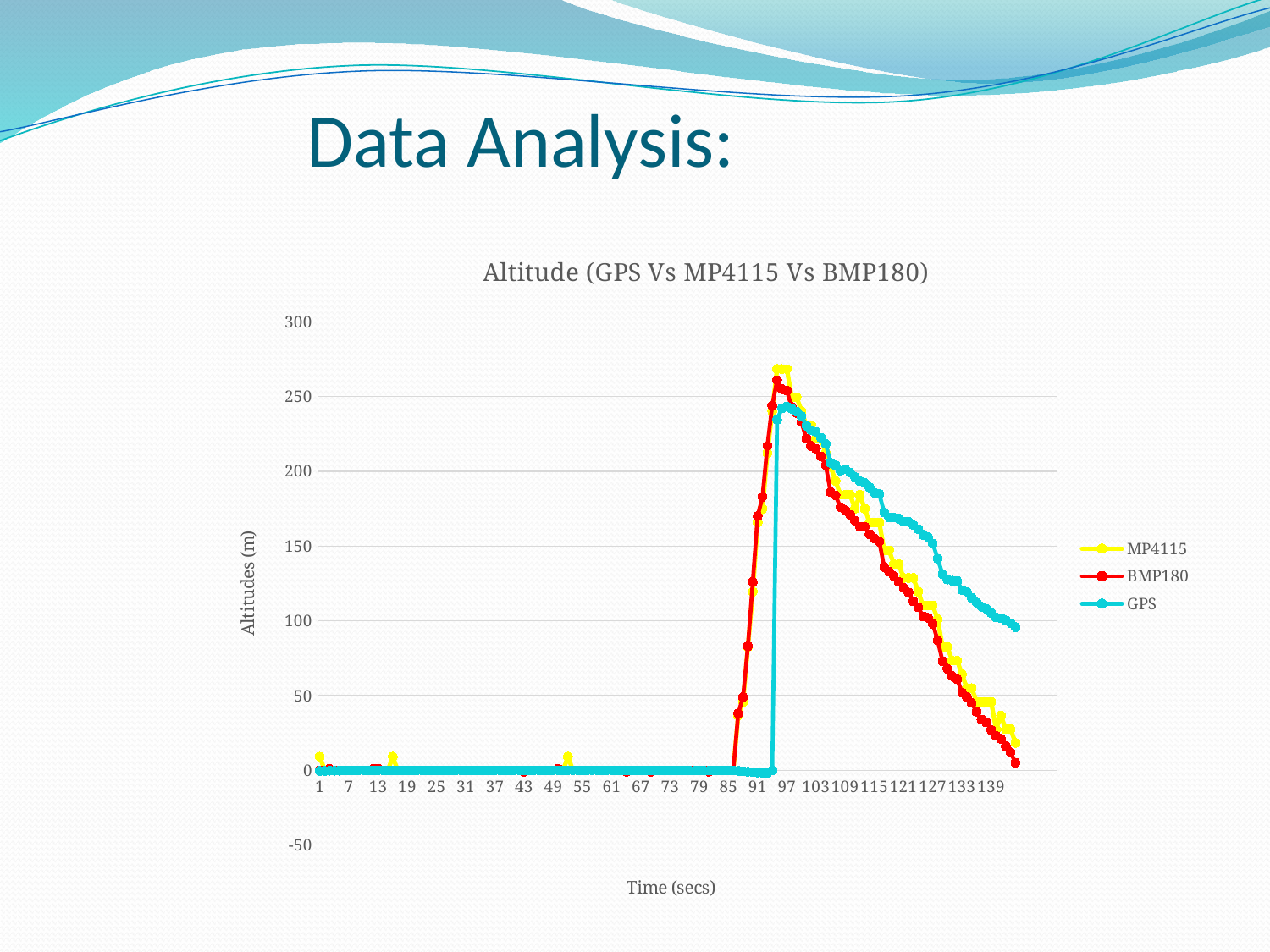
Is the peak value of the MP4115 series greater or less than 250? greater After reaching their peaks, do the altitude values rise or fall as time increases? fall How many series does the legend list? 3 Which series has the lowest peak altitude? GPS What is the title of the chart? Altitude (GPS Vs MP4115 Vs BMP180) Which series has the higher altitude at the last time point plotted, GPS or BMP180? GPS What is the label of the vertical axis? Altitudes (m) Is the peak value of the GPS series greater or less than 250? less Are the altitude values for all three series greater or less than 50 between time 1 and time 79? less Which series reaches the highest peak altitude? MP4115 What type of chart is shown on the slide? Line chart